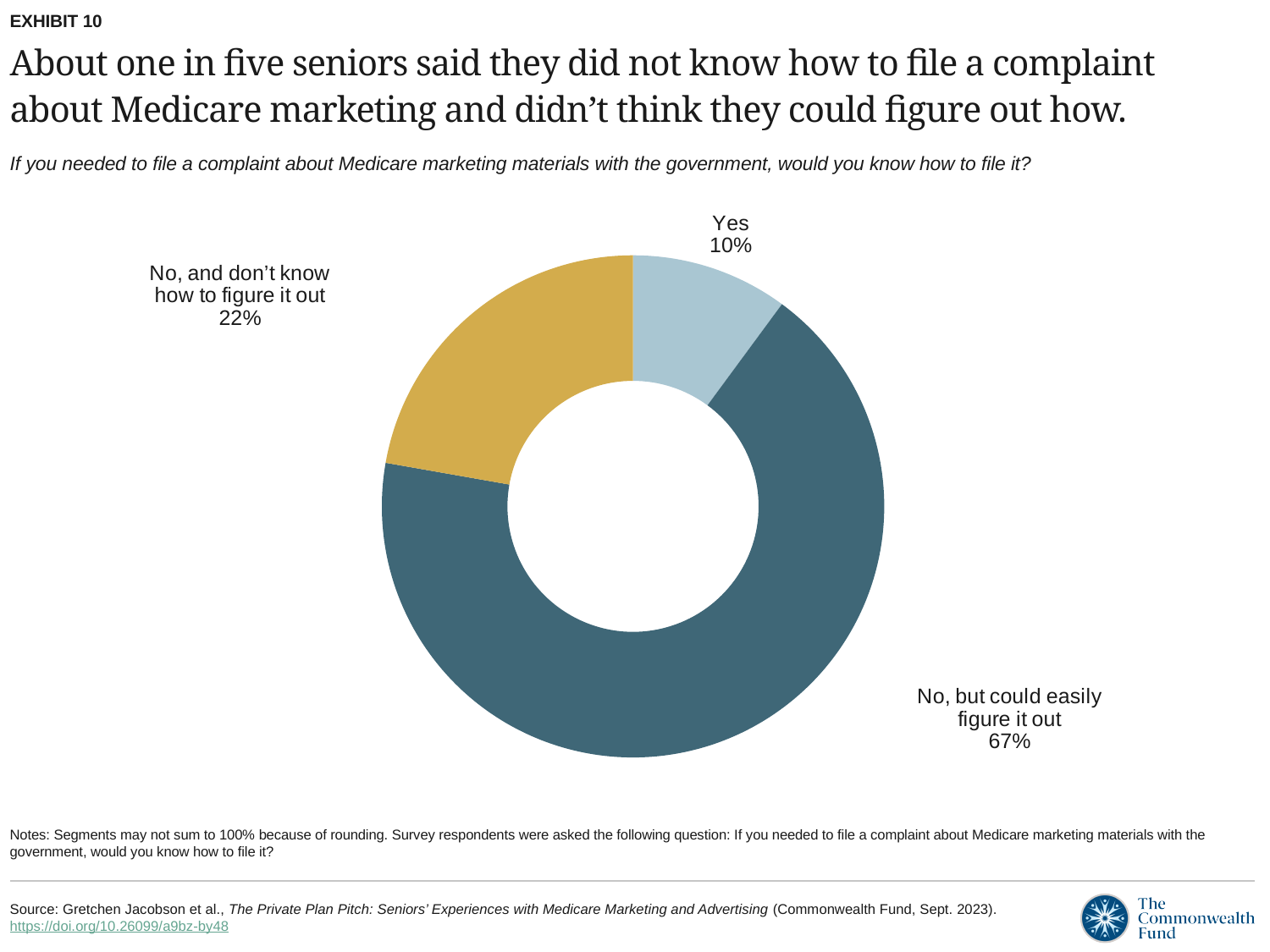
Which response has the largest share of the chart? No, but could easily figure it out Which response has the smallest share of the chart? Yes What colour is the segment for "No, and don't know how to figure it out"? Gold/yellow What is the difference in percentage points between "No, but could easily figure it out" and "No, and don't know how to figure it out"? 45 What percentage of seniors answered "No, but could easily figure it out"? 67% What percentage of seniors answered "No, and don't know how to figure it out"? 22% What is the difference in percentage points between "No, and don't know how to figure it out" and "Yes"? 12 What percentage of seniors answered "Yes"? 10% Which is larger: the share for "Yes" or the share for "No, and don't know how to figure it out"? No, and don't know how to figure it out How many segments does the chart have? 3 What kind of chart is shown on the slide? Pie chart (donut) What survey question is the chart based on, as shown in the subtitle? If you needed to file a complaint about Medicare marketing materials with the government, would you know how to file it?